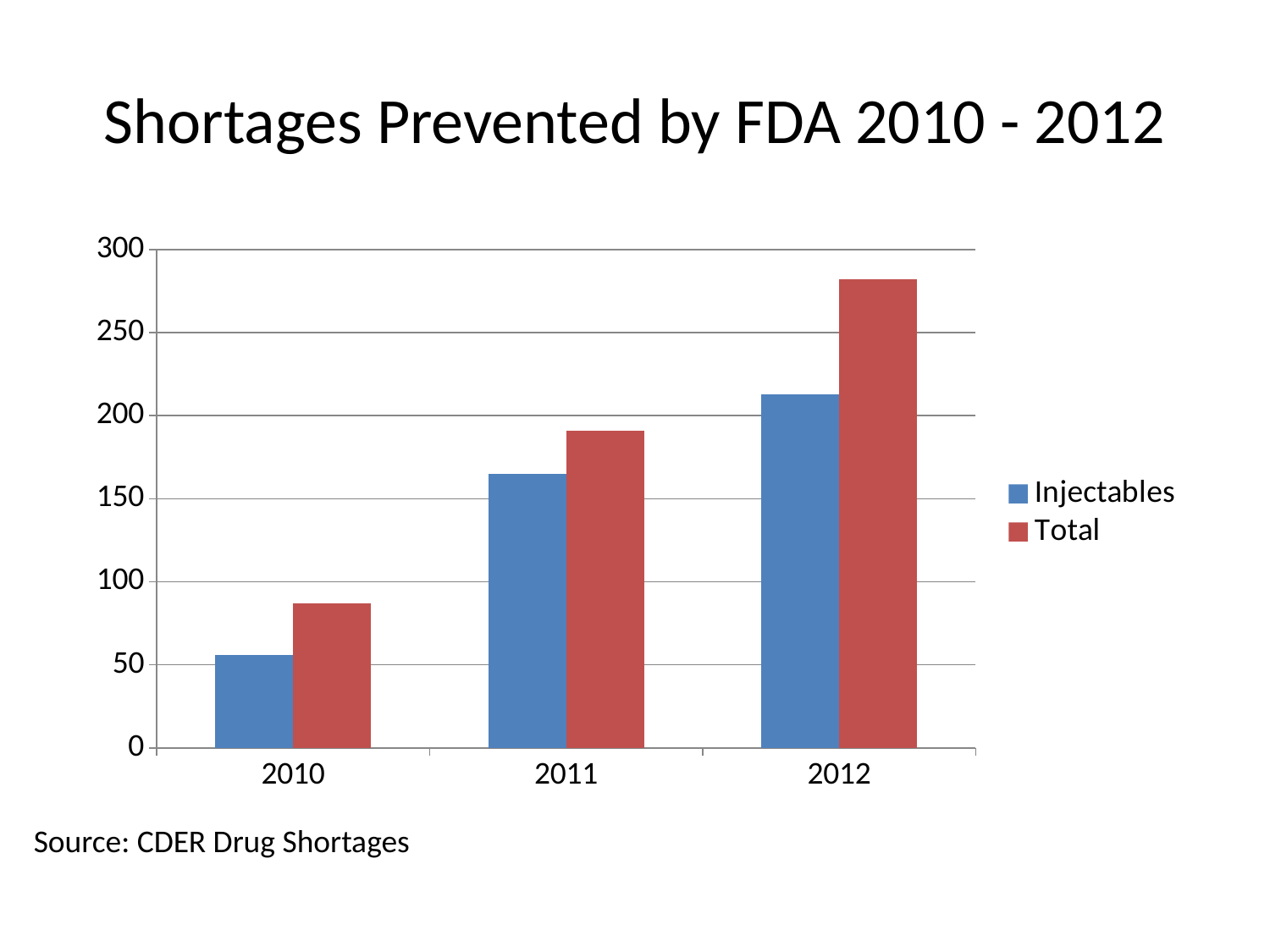
Is the Injectables value for 2011 greater or less than 150? greater Do the Injectables values rise or fall from 2010 to 2012? rise Which is larger in 2011, Injectables or Total? Total Is the Total value for 2010 greater or less than 100? less Is the Injectables value for 2012 greater or less than 200? greater How many series does the legend list? 2 Which year has the highest Total value? 2012 What kind of chart is shown on the slide? bar chart Which year has the lowest Injectables value? 2010 How many years are shown on the x axis? 3 What is the title of the chart? Shortages Prevented by FDA 2010 - 2012